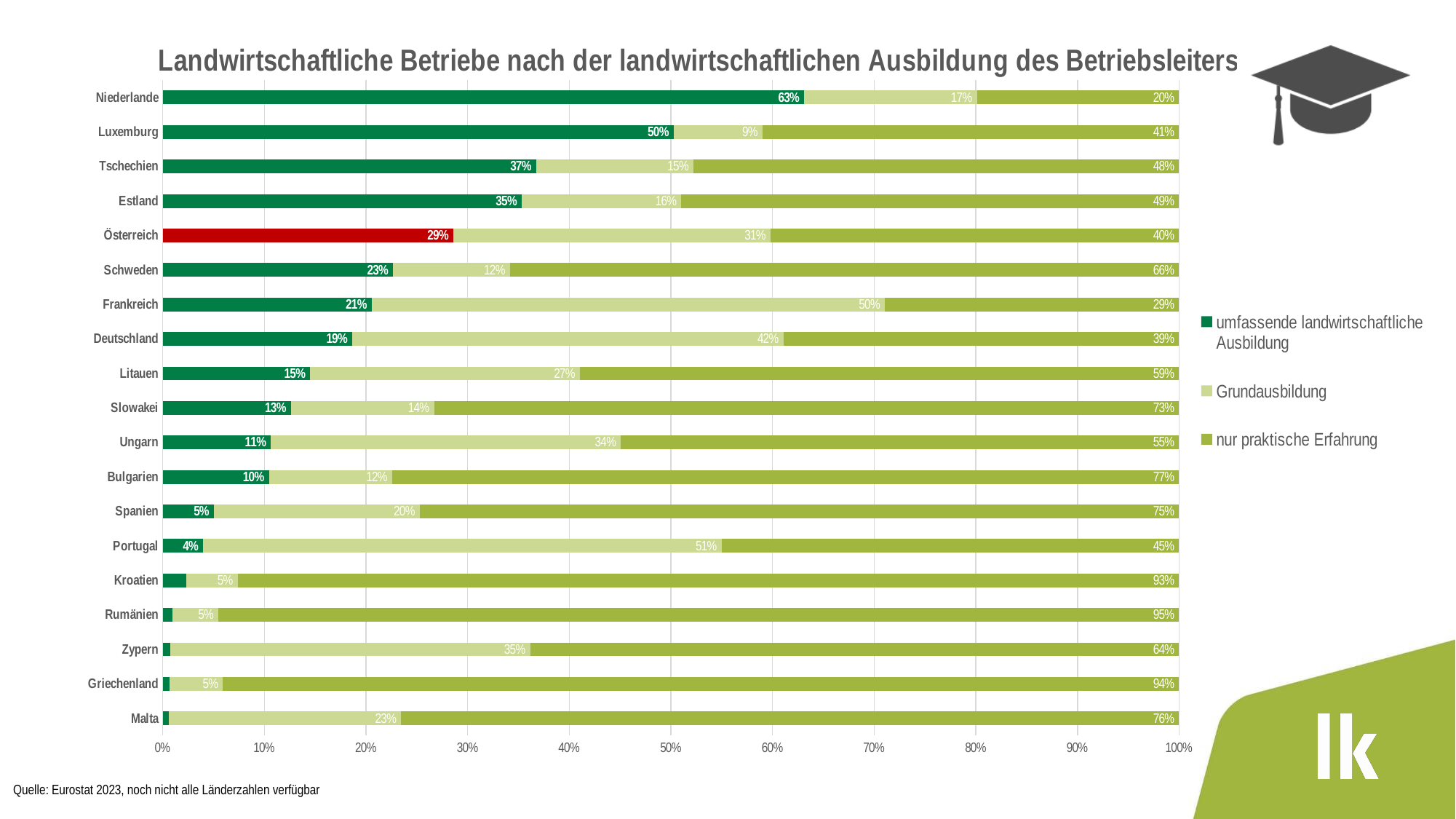
What is the 'nur praktische Erfahrung' value for Malta? 76% Which country has the lowest share of 'nur praktische Erfahrung'? Niederlande What percentage of farms in Niederlande have an 'umfassende landwirtschaftliche Ausbildung' manager? 63% Which has a larger 'nur praktische Erfahrung' share, Schweden or Litauen? Schweden Which country's 'umfassende landwirtschaftliche Ausbildung' bar is highlighted in red? Österreich How much higher is the 'umfassende landwirtschaftliche Ausbildung' share in Luxemburg than in Tschechien? 13 percentage points Which country has the highest share of 'nur praktische Erfahrung'? Rumänien What is the difference between the 'Grundausbildung' and 'nur praktische Erfahrung' values for Deutschland? 3 percentage points How many countries are shown in the chart? 19 What is the 'Grundausbildung' value for Österreich? 31% Which country has the highest share of 'umfassende landwirtschaftliche Ausbildung'? Niederlande How many series does the legend list? 3